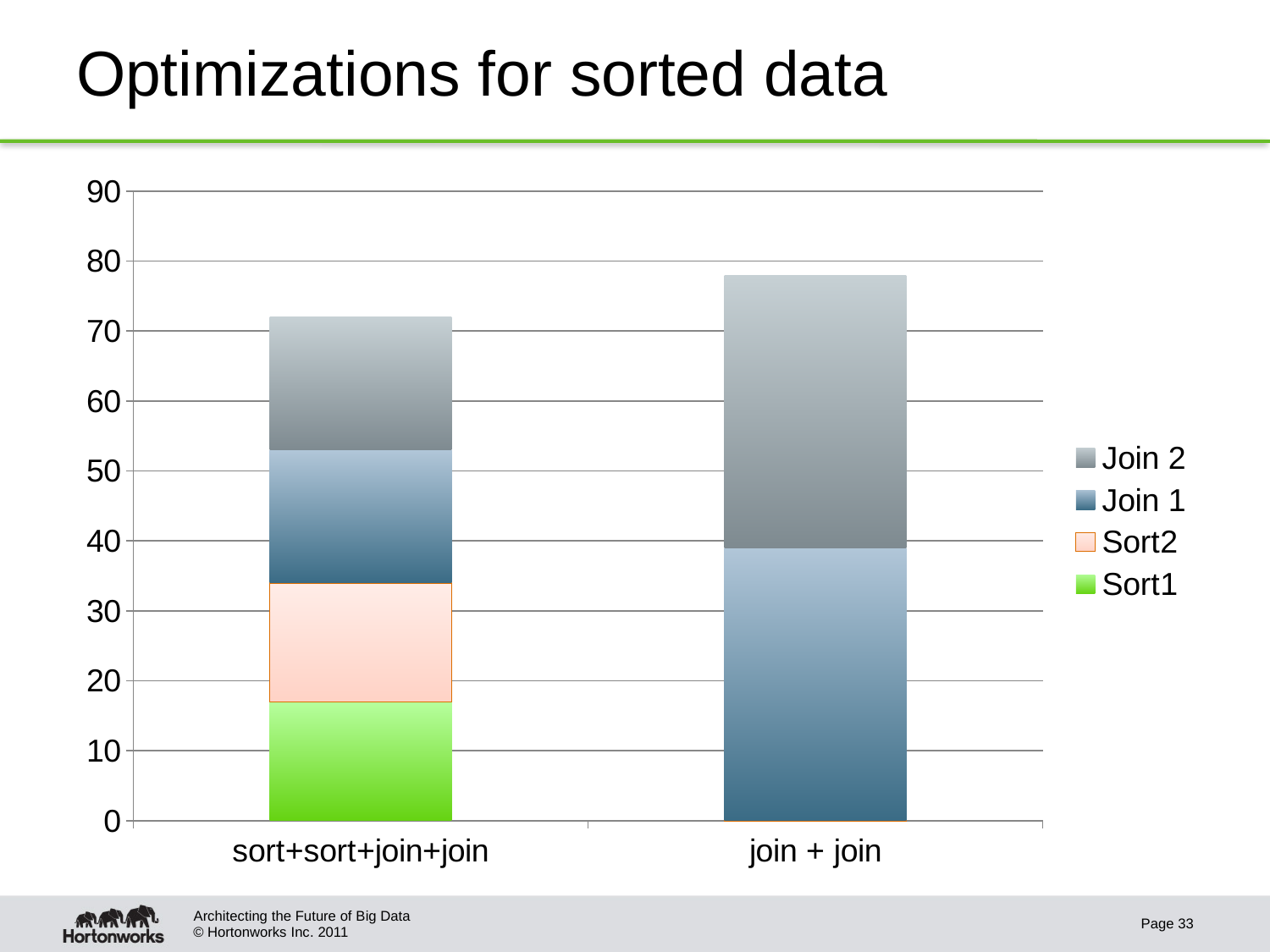
Which category has the taller stacked bar? join + join Is the total value for join + join greater or less than 70? greater What is the title of the slide containing the chart? Optimizations for sorted data Is the Sort1 value for sort+sort+join+join greater or less than 20? less How many categories are shown on the x axis? 2 Is the total stacked bar for join + join larger or smaller than the total for sort+sort+join+join? larger Which category has the shorter stacked bar? sort+sort+join+join Is the total value for sort+sort+join+join greater or less than 60? greater What kind of chart is shown on the slide? bar chart Which series appears at the top of the legend? Join 2 How many series does the legend list? 4